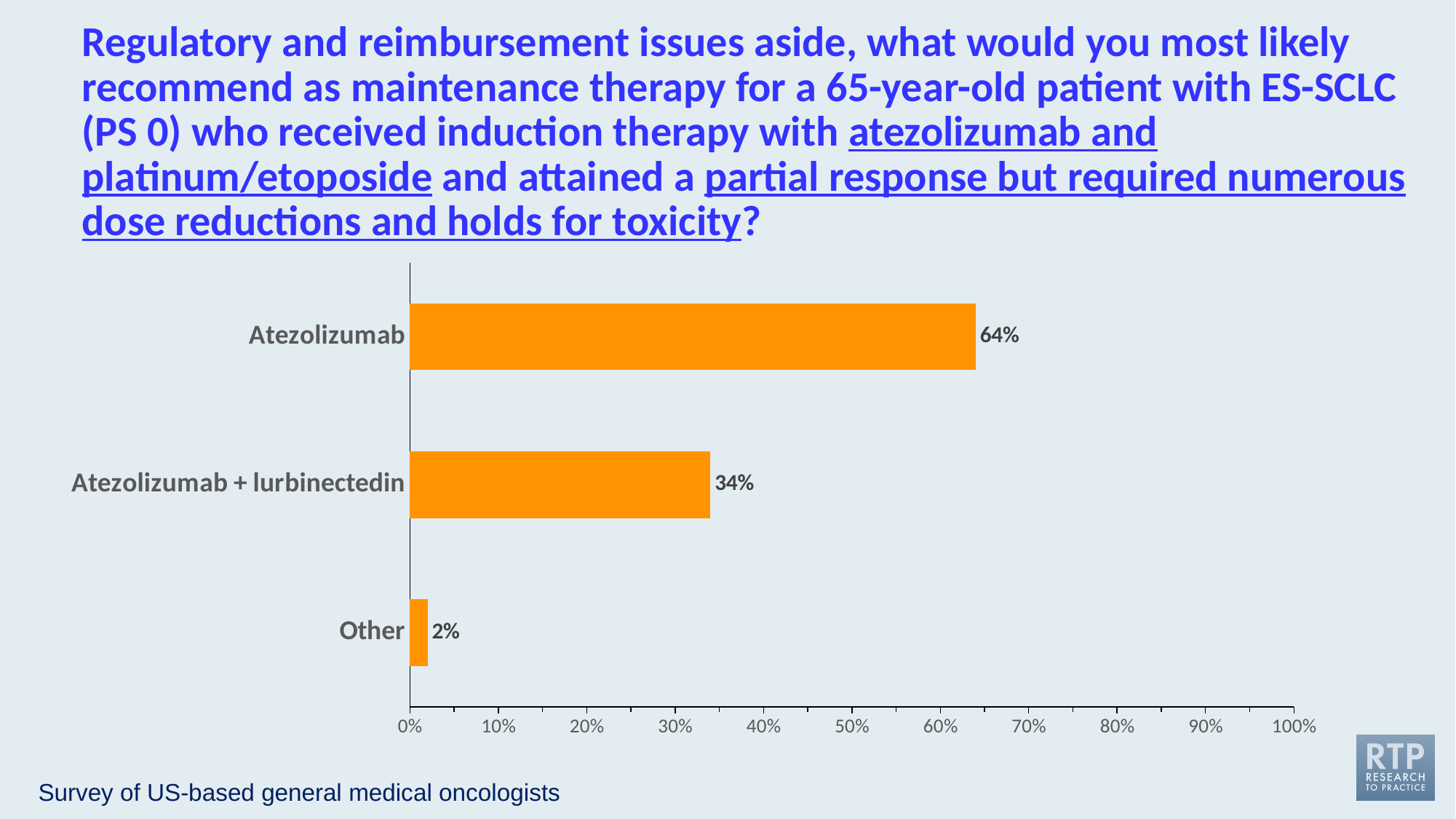
What percentage of respondents chose Other? 2% How many categories are shown in the chart? 3 Is the value for Atezolizumab + lurbinectedin greater or less than 40%? less Which option has the lowest percentage? Other Is the value for Atezolizumab greater or less than 50%? greater Which option has the highest percentage? Atezolizumab Which is larger, the value for Atezolizumab + lurbinectedin or the value for Other? Atezolizumab + lurbinectedin What is the maximum value shown on the x axis? 100% What kind of chart is shown on the slide? Bar chart What percentage of respondents chose Atezolizumab? 64% What is the difference in percentage points between Atezolizumab and Atezolizumab + lurbinectedin? 30 What percentage of respondents chose Atezolizumab + lurbinectedin? 34%